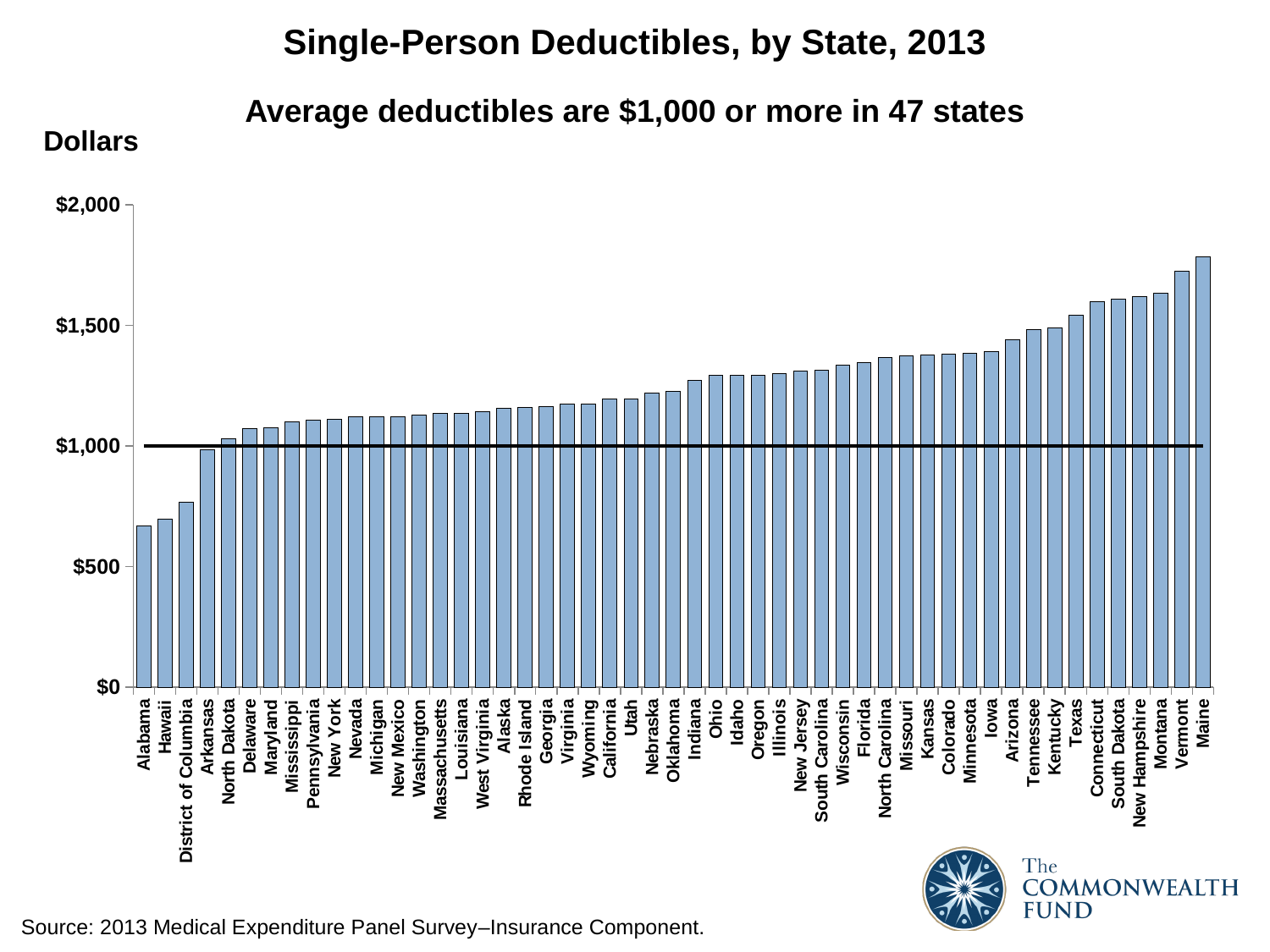
Is the value for Vermont greater or less than $1,500? greater Is the value for Alabama greater or less than $1,000? less Which state has the lowest single-person deductible on the chart? Alabama Do the values rise or fall moving from left to right along the x axis? rise Which has the larger deductible, Vermont or Montana? Vermont Which state has the highest single-person deductible on the chart? Maine Is the value for Maine greater or less than $1,500? greater How many bars (states and DC) are plotted on the chart? 51 What value does the horizontal reference line across the chart mark? $1,000 What kind of chart is shown on the slide? bar chart